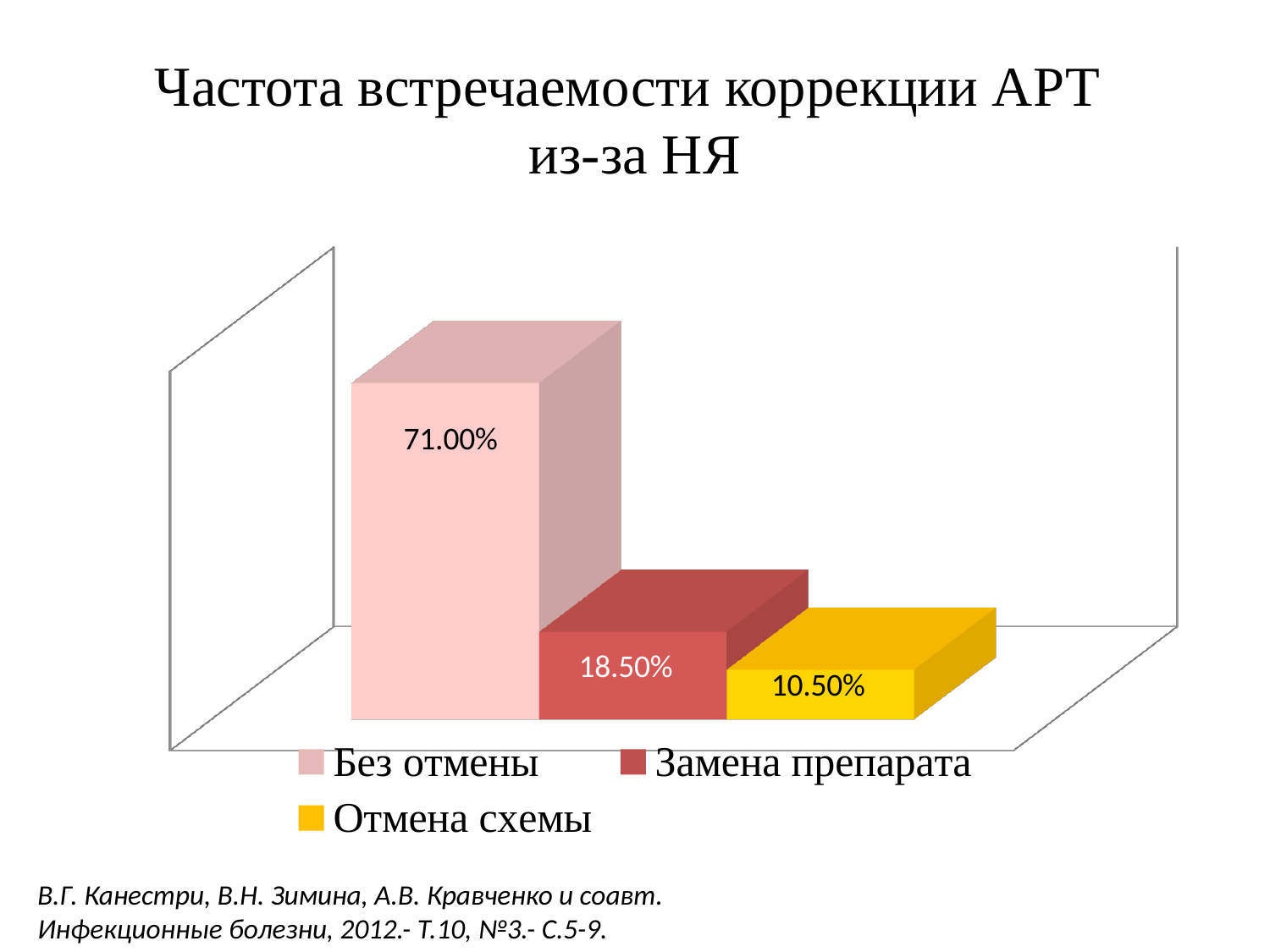
Which is larger, the value for Замена препарата or the value for Отмена схемы? Замена препарата Which series has the lowest value? Отмена схемы What kind of chart is shown on the slide? Bar chart What is the value for Без отмены? 71.00% Which series has the highest value? Без отмены What is the title of the chart on the slide? Частота встречаемости коррекции АРТ из-за НЯ How many series does the legend list? 3 What is the difference between the values for Замена препарата and Отмена схемы? 8.00% What is the value for Отмена схемы? 10.50% What is the difference between the values for Без отмены and Замена препарата? 52.50% What is the value for Замена препарата? 18.50% What colour is the bar for Отмена схемы? Yellow